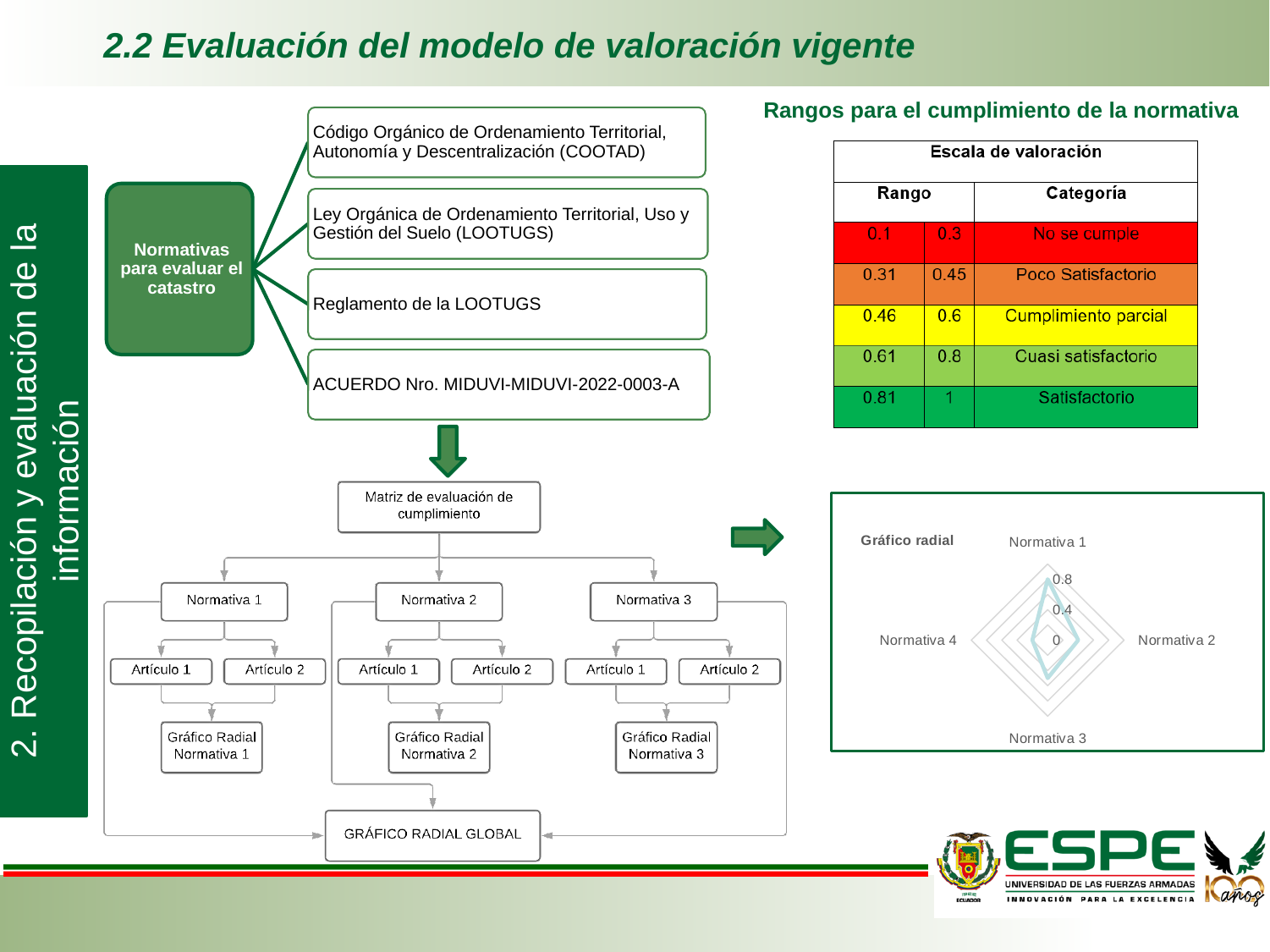
In the 'Gráfico radial' chart, which is larger: the value for Normativa 1 or the value for Normativa 4? Normativa 1 In the 'Gráfico radial' chart, which is larger: the value for Normativa 1 or the value for Normativa 3? Normativa 1 What is the highest tick value shown on the axis of the 'Gráfico radial' chart? 0.8 In the 'Gráfico radial' chart, is the value for Normativa 1 greater or less than 0.4? greater How many categories (axes) does the 'Gráfico radial' chart have? 4 In the 'Gráfico radial' chart, is the value for Normativa 4 greater or less than 0.4? less What is the title of the radar chart on the slide? Gráfico radial What kind of chart is the 'Gráfico radial' chart on the slide? Radar chart Which category has the highest value in the 'Gráfico radial' chart? Normativa 1 In the 'Gráfico radial' chart, is the value for Normativa 3 greater or less than 0.4? greater